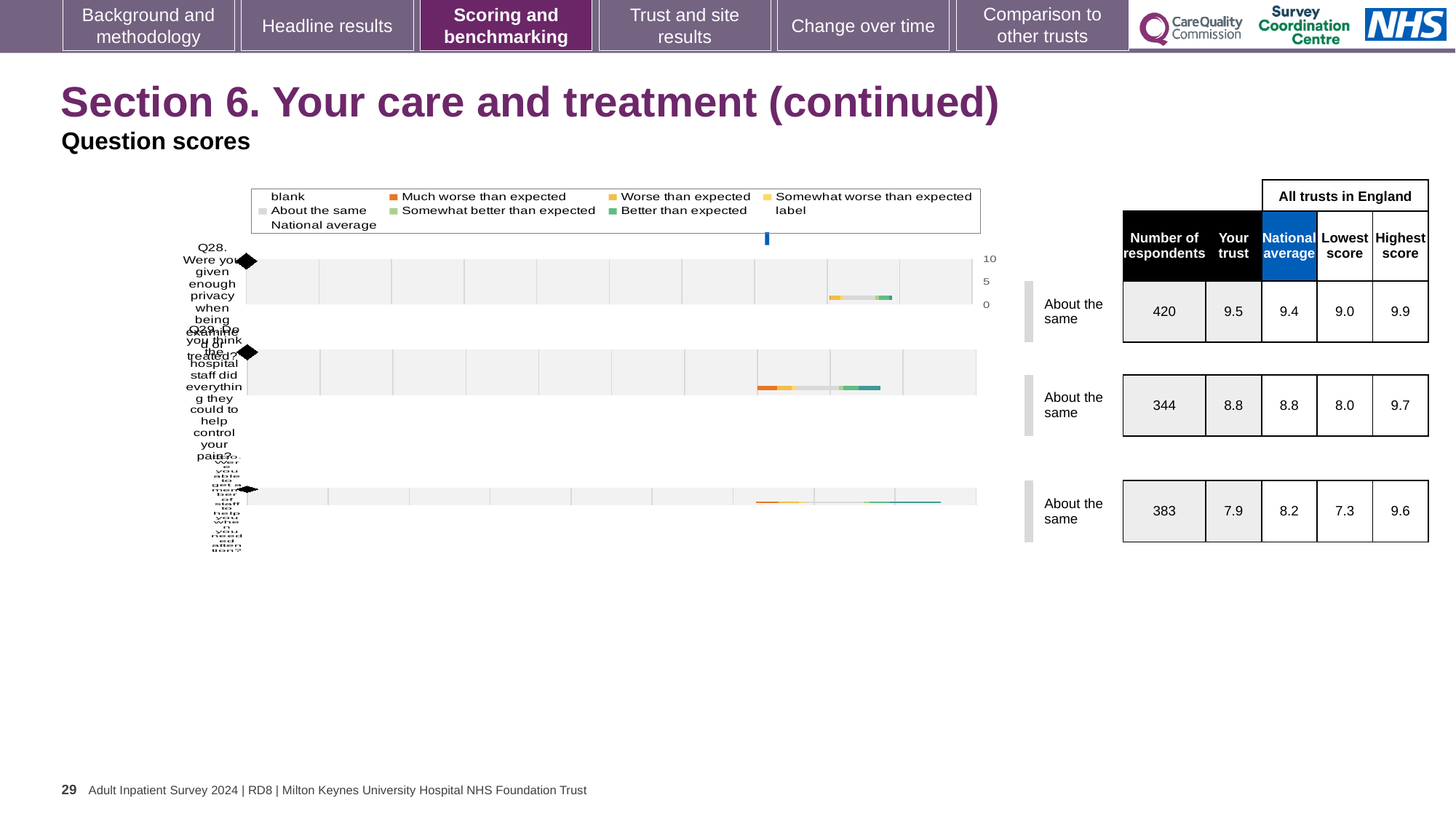
How many questions (Q28, Q29, Q30) are plotted in the chart area on this slide? 3 How many respondents answered Q30 (Were you able to get a member of staff to help you when you needed attention?)? 383 For Q28, which is higher: the 'Your trust' score or the national average? Your trust What is the national average score for Q29 (Do you think the hospital staff did everything they could to help control your pain?)? 8.8 What kind of chart is used to show the question scores on this slide? bar chart Which question has the highest 'Your trust' score on this slide? Q28 For Q30, what is the difference between the highest score and the lowest score across all trusts in England? 2.3 What is the 'Your trust' score for Q28 (Were you given enough privacy when being examined or treated?)? 9.5 What benchmark category is shown next to the Q29 chart? About the same What colour does the chart legend use for 'Much worse than expected'? orange What is the highest tick value shown on the score axis of the Q28 chart? 10 Which question has the lowest number of respondents on this slide? Q29